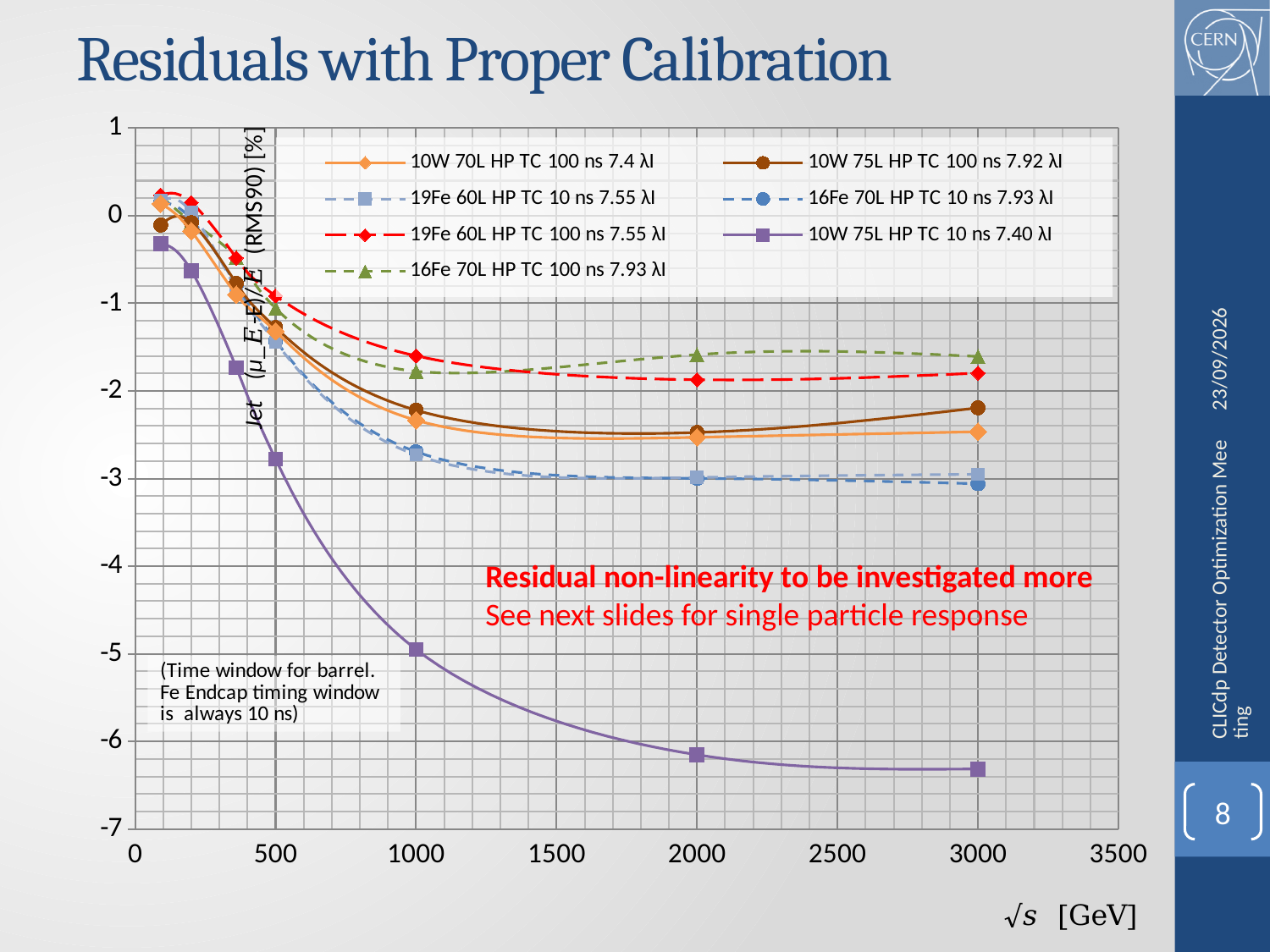
What kind of chart is shown on the slide? line chart What is the x-axis label of the chart? √s [GeV] Is the value for 10W 70L HP TC 100 ns 7.4 λI at 1000 GeV greater or less than -2? less Is the value for 16Fe 70L HP TC 100 ns 7.93 λI at 3000 GeV greater or less than -2? greater Which series has the lowest value at 3000 GeV? 10W 75L HP TC 10 ns 7.40 λI Is the value for 10W 75L HP TC 10 ns 7.40 λI at 500 GeV greater or less than -2? less Which series has the highest value at 3000 GeV? 16Fe 70L HP TC 100 ns 7.93 λI What is the title of the chart? Residuals with Proper Calibration Does the 10W 75L HP TC 10 ns 7.40 λI series rise or fall as √s increases from 500 to 3000 GeV? fall At 2000 GeV, which series has the larger value: 16Fe 70L HP TC 100 ns 7.93 λI or 10W 75L HP TC 10 ns 7.40 λI? 16Fe 70L HP TC 100 ns 7.93 λI How many series does the legend list? 7